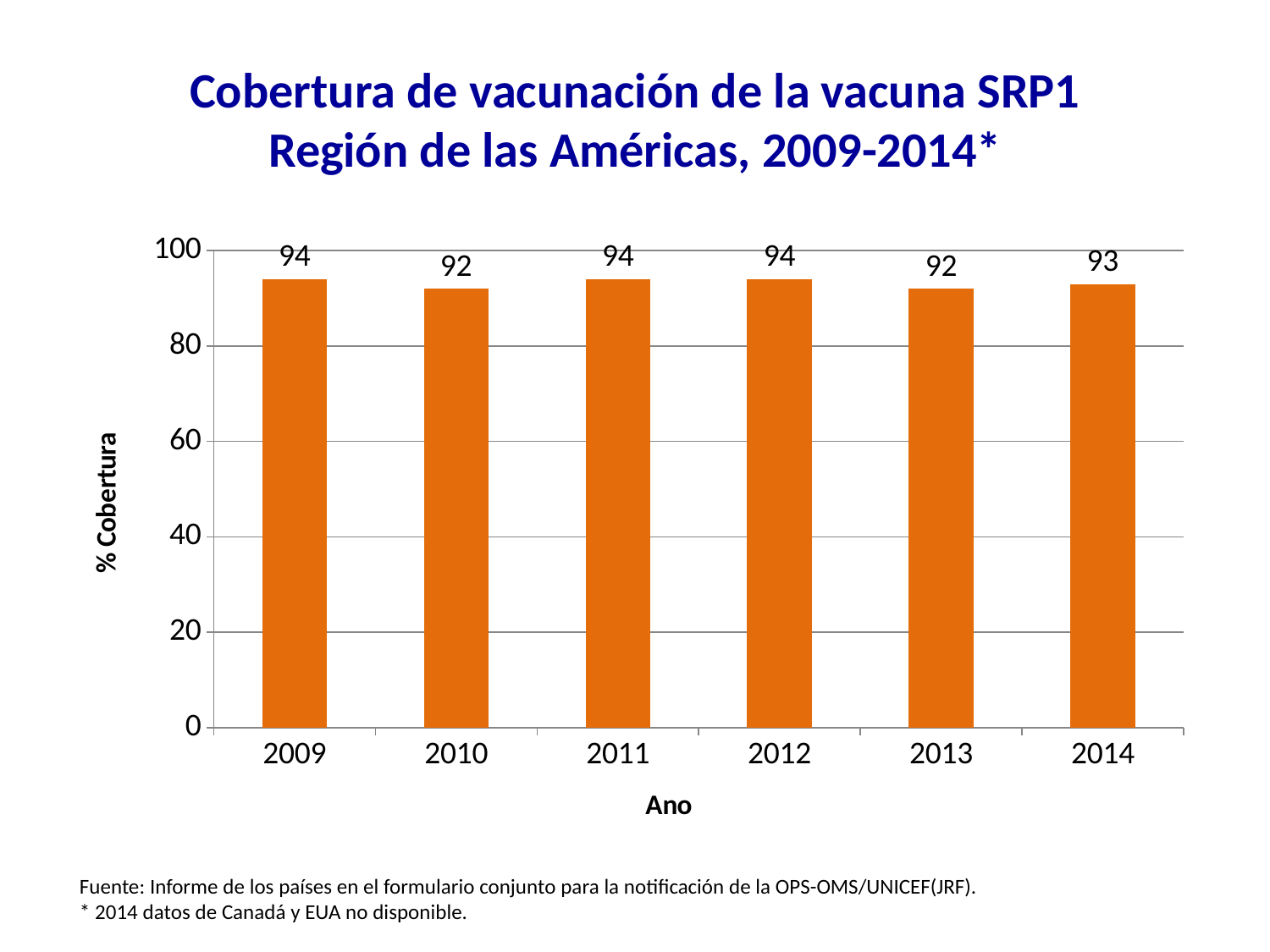
What is the coverage value for 2013? 92 What is the coverage value for 2010? 92 Is the coverage value for 2012 greater or less than 80? greater What is the difference between the coverage values for 2014 and 2013? 1 What kind of chart is shown on the slide? bar chart What is the coverage value for 2014? 93 What is the label of the x axis? Ano What is the coverage value for 2009? 94 Which is larger, the coverage value for 2011 or for 2013? 2011 What is the label of the y axis? % Cobertura How many years are shown on the x axis? 6 What is the difference between the coverage values for 2009 and 2010? 2